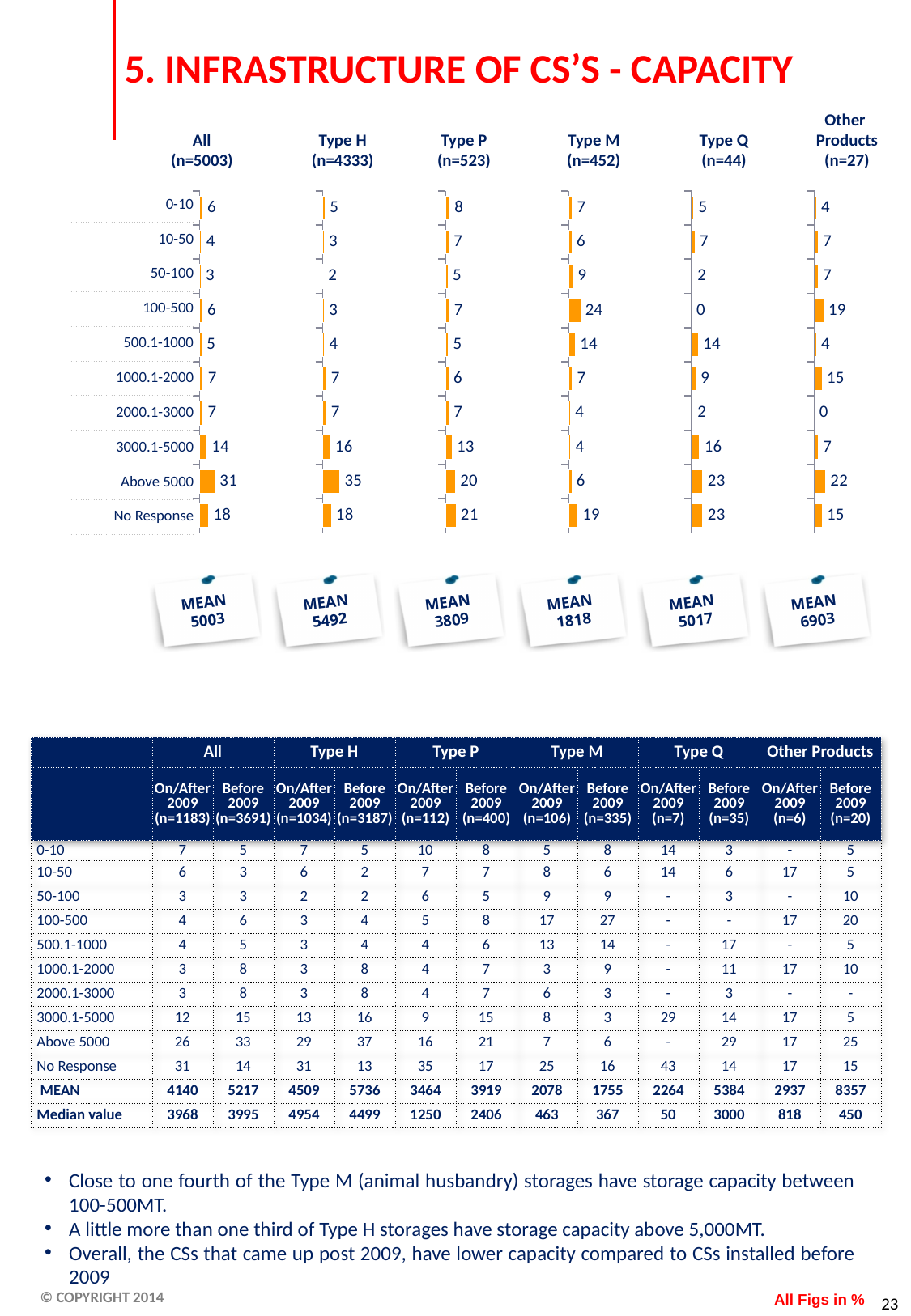
What is the title of the slide containing these charts? 5. INFRASTRUCTURE OF CS'S - CAPACITY What kind of chart is used for the 'Type P (n=523)' data? Bar chart In the 'Type M (n=452)' chart, what is the value for '100-500'? 24 In the 'Type H (n=4333)' chart, which category has the highest value? Above 5000 In the 'Type H (n=4333)' chart, what is the difference between the values for 'Above 5000' and '3000.1-5000'? 19 In the 'Type Q (n=44)' chart, what is the value for 'No Response'? 23 In the 'Other Products (n=27)' chart, what is the value for '1000.1-2000'? 15 In the 'All (n=5003)' chart, what is the value for 'Above 5000'? 31 How many categories are shown in the 'All (n=5003)' chart? 10 In the 'Type Q (n=44)' chart, which category has the lowest value? 100-500 In the 'Type M (n=452)' chart, which category has the highest value? 100-500 In the 'Other Products (n=27)' chart, which is larger: the value for '100-500' or the value for 'Above 5000'? Above 5000